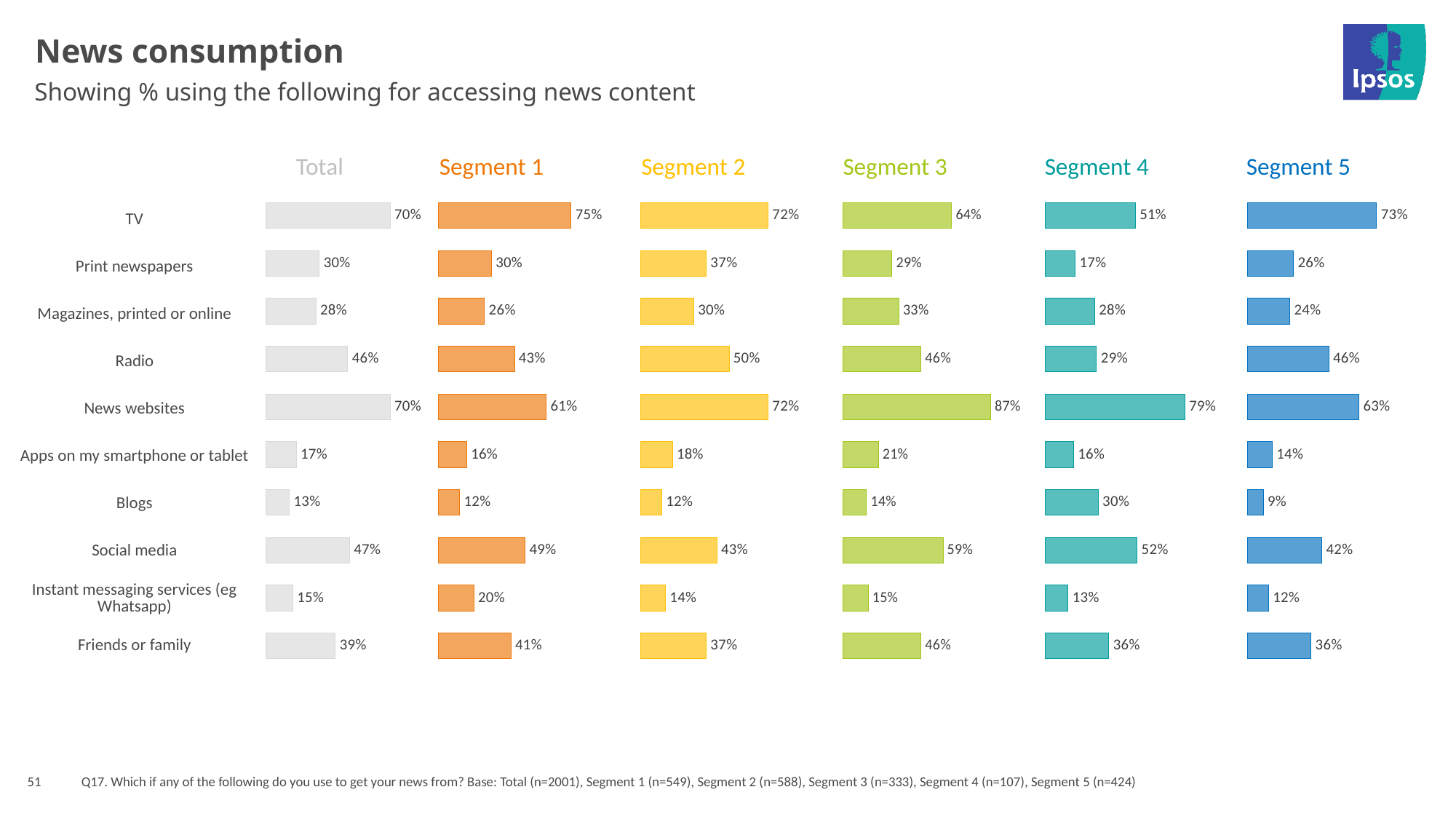
What kind of chart is used for the Segment 1 data? Bar chart In the Segment 5 chart, which category has the lowest value? Blogs In the Segment 4 chart, what is the value for Blogs? 30% How many separate charts (Total plus segments) are shown on the slide? 6 How much higher is the Social media value in the Segment 3 chart than in the Total chart? 12 percentage points In the Segment 2 chart, which is larger: Print newspapers or Magazines, printed or online? Print newspapers In the Segment 1 chart, what is the difference between the TV value and the News websites value? 14 percentage points In the Segment 3 chart, what percentage use news websites for accessing news content? 87% In the Segment 1 chart, which category has the highest value? TV How many categories are plotted in the Total chart? 10 In the Segment 4 chart, which category has the highest value? News websites In the Total chart, what is the value for Social media? 47%